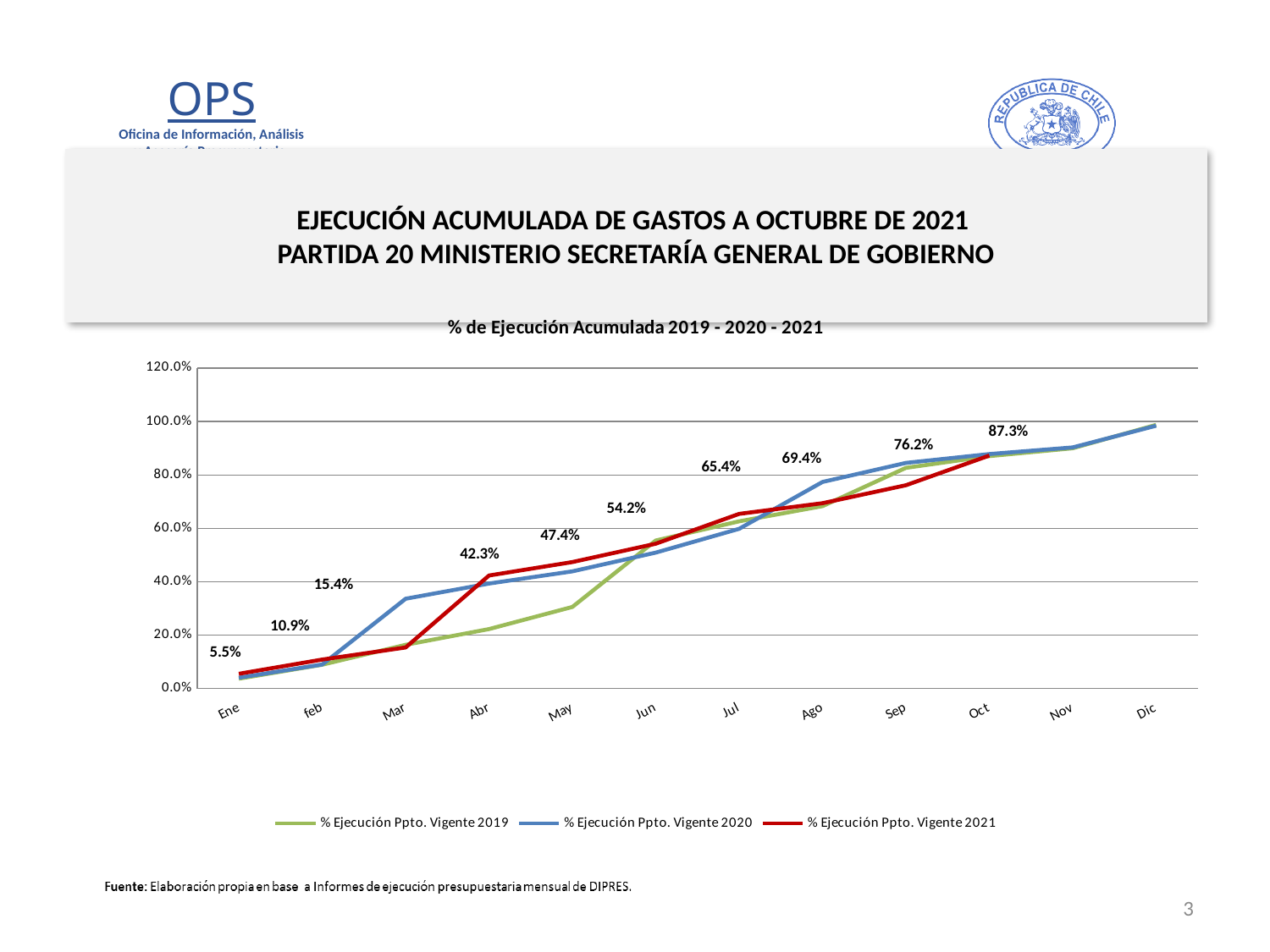
What is the value of % Ejecución Ppto. Vigente 2021 in Oct? 87.3% Does the % Ejecución Ppto. Vigente 2021 line rise or fall from Ene to Oct? rise What is the value of % Ejecución Ppto. Vigente 2021 in Abr? 42.3% What is the title of the chart? % de Ejecución Acumulada 2019 - 2020 - 2021 What is the difference between the 2021 values for Oct and Sep? 11.1% Is the value of % Ejecución Ppto. Vigente 2020 in Dic greater or less than 80.0%? greater How many series does the legend list? 3 How many months are shown on the x axis? 12 What is the difference between the 2021 values for Abr and Mar? 26.9% What type of chart is shown on the slide? line chart What is the value of % Ejecución Ppto. Vigente 2021 in Ene? 5.5% What is the value of % Ejecución Ppto. Vigente 2021 in Jul? 65.4%